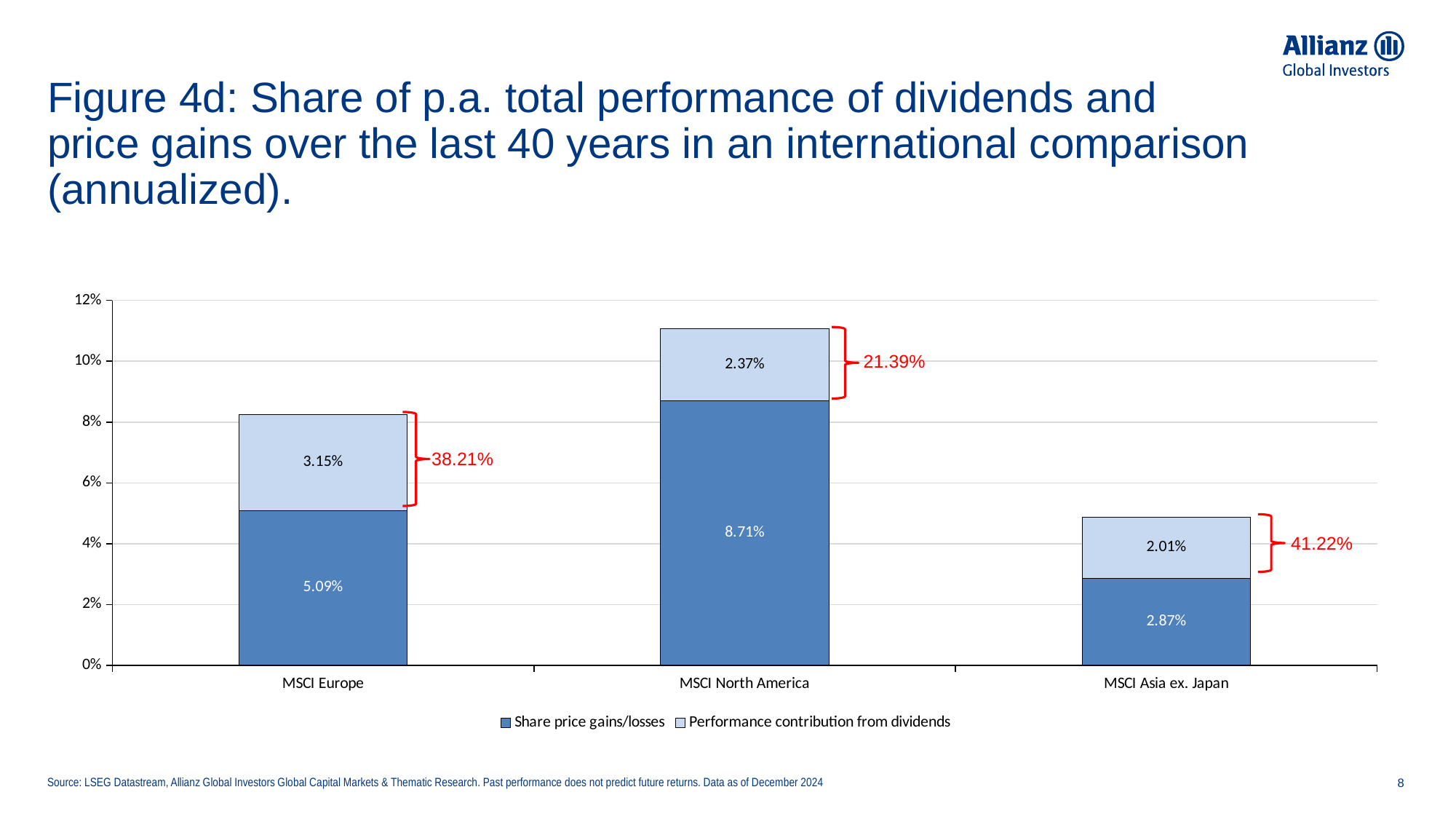
Which is larger: the dividend contribution for MSCI Europe or for MSCI North America? MSCI Europe What red percentage is annotated next to the MSCI Asia ex. Japan bar? 41.22% What is the performance contribution from dividends for MSCI Europe? 3.15% What is the share price gains/losses value for MSCI Asia ex. Japan? 2.87% What is the difference between the share price gains/losses of MSCI North America and MSCI Europe? 3.62% Which region has the lowest performance contribution from dividends? MSCI Asia ex. Japan Which region has the highest share price gains/losses value? MSCI North America What is the total height of the stacked bar for MSCI North America? 11.08% How many series does the legend list? 2 What is the share price gains/losses value for MSCI North America? 8.71% What is the total height of the stacked bar for MSCI Asia ex. Japan? 4.88% How many regions are shown on the x axis? 3